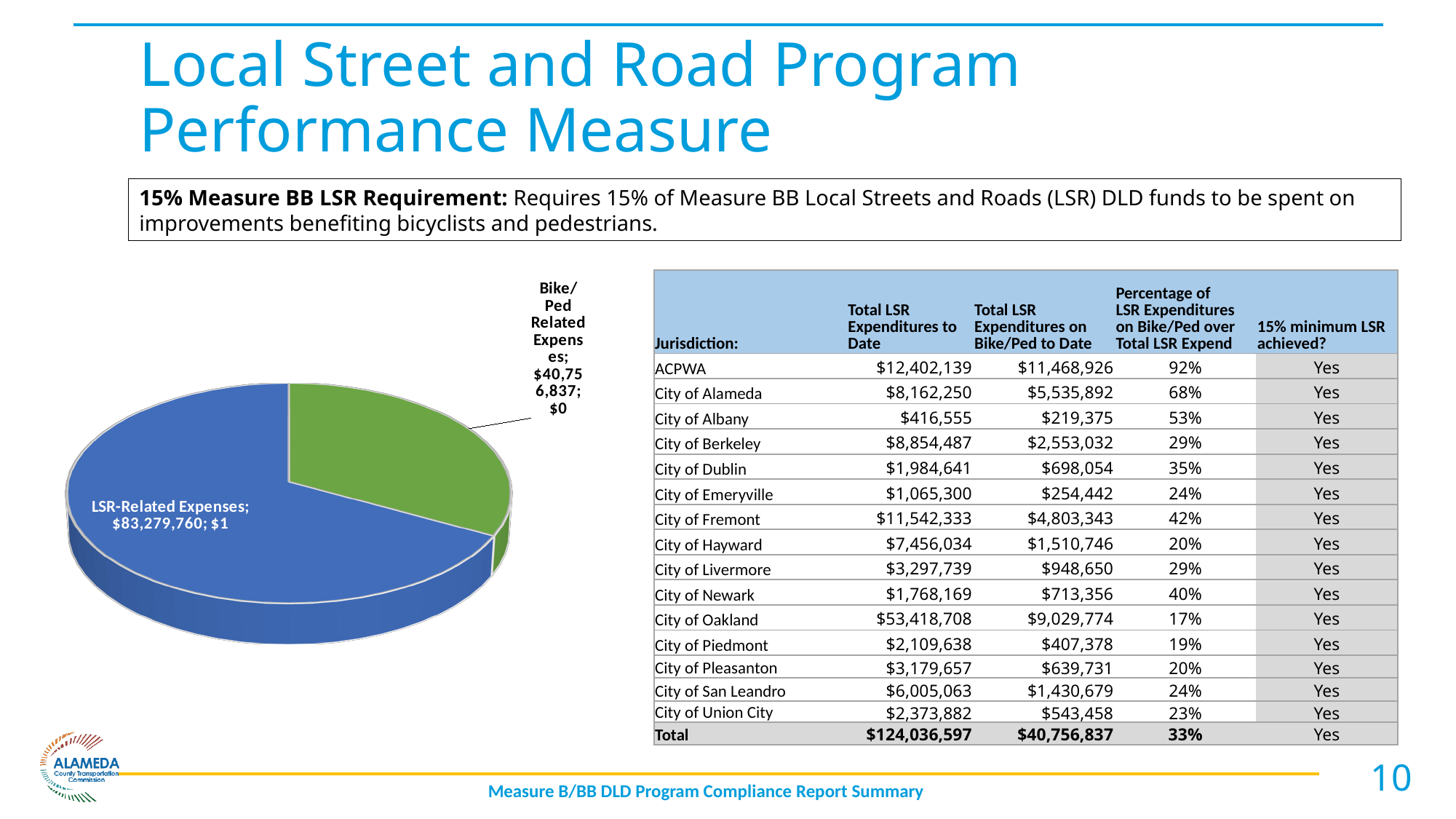
What is the value shown for Bike/Ped Related Expenses in the pie chart? $40,756,837 How many slices does the pie chart have? 2 Which slice of the pie chart is the smallest? Bike/Ped Related Expenses What kind of chart is shown on the slide? pie chart Which slice of the pie chart is the largest? LSR-Related Expenses What is the combined total of the two slices in the pie chart? $124,036,597 What share of the pie chart does the Bike/Ped Related Expenses slice represent? 33% What is the difference between LSR-Related Expenses and Bike/Ped Related Expenses in the pie chart? $42,522,923 What is the value shown for LSR-Related Expenses in the pie chart? $83,279,760 What colour is the Bike/Ped Related Expenses slice in the pie chart? green In the pie chart, which is larger: LSR-Related Expenses or Bike/Ped Related Expenses? LSR-Related Expenses What colour is the LSR-Related Expenses slice in the pie chart? blue